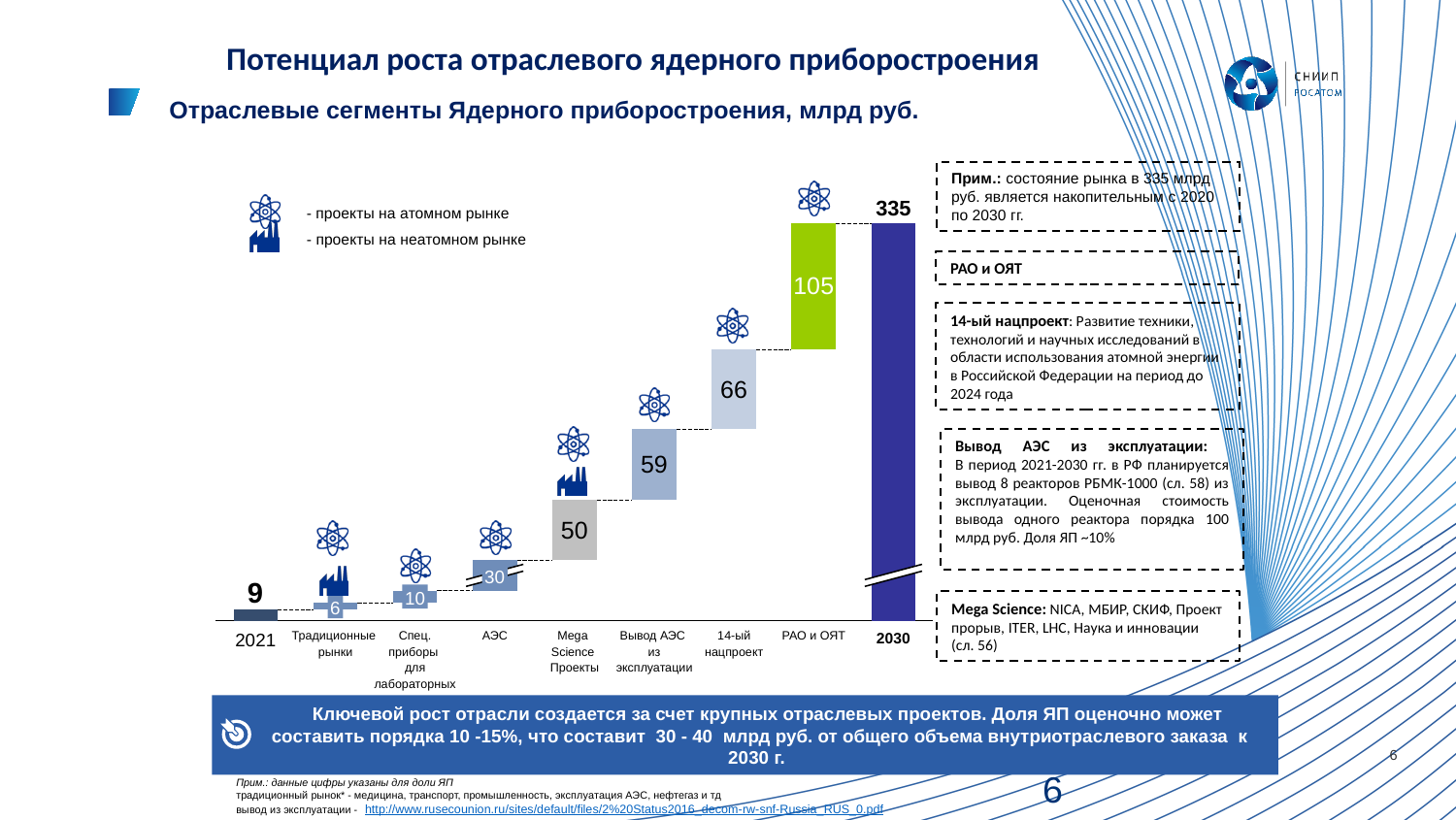
What is the difference between the 14-ый нацпроект value and the Вывод АЭС из эксплуатации value? 7 What is the value shown for the АЭС segment? 30 What is the value shown for the Вывод АЭС из эксплуатации segment? 59 What is the value shown for the РАО и ОЯТ segment? 105 How many categories are shown along the x axis of the chart? 9 What is the value shown for the Mega Science Проекты segment? 50 What is the value shown for 2030 on the chart? 335 Which is larger: the value for Спец. приборы для лабораторных or the value for Традиционные рынки? Спец. приборы для лабораторных Which segment has the lowest value on the chart? Традиционные рынки Which intermediate segment (excluding the 2021 and 2030 totals) has the highest value? РАО и ОЯТ What kind of chart is shown on the slide? bar chart What is the value shown for 2021 on the chart? 9